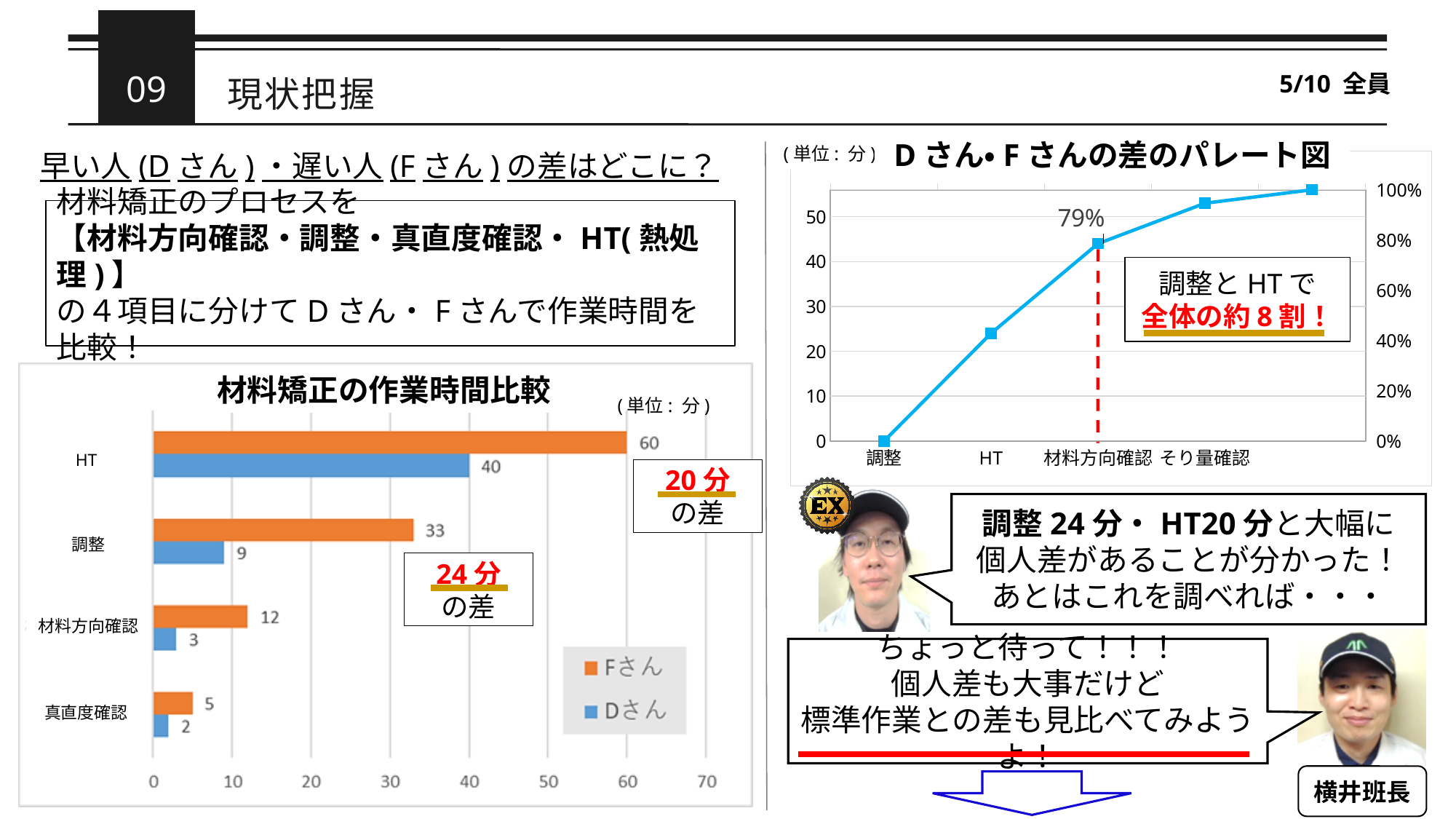
In the 材料矯正の作業時間比較 chart, what is the value for Fさん for 材料方向確認? 12 In the 材料矯正の作業時間比較 chart, which category has the lowest value for Dさん? 真直度確認 In the 材料矯正の作業時間比較 chart, what is the value for Fさん for HT? 60 In the 材料矯正の作業時間比較 chart, what is the value for Dさん for 調整? 9 In the 材料矯正の作業時間比較 chart, what is the difference between Fさん and Dさん for 調整? 24 What kind of chart is the 材料矯正の作業時間比較 chart? bar chart In the 材料矯正の作業時間比較 chart, which is larger for 材料方向確認: Fさん or Dさん? Fさん In the 材料矯正の作業時間比較 chart, which category has the highest value for Fさん? HT How many series does the legend of the 材料矯正の作業時間比較 chart list? 2 In the 材料矯正の作業時間比較 chart, what is the difference between Fさん and Dさん for HT? 20 In the DさんFさんの差のパレート図 chart, what cumulative percentage is labelled on the line at the third point? 79% In the 材料矯正の作業時間比較 chart, what is the value for Dさん for 真直度確認? 2